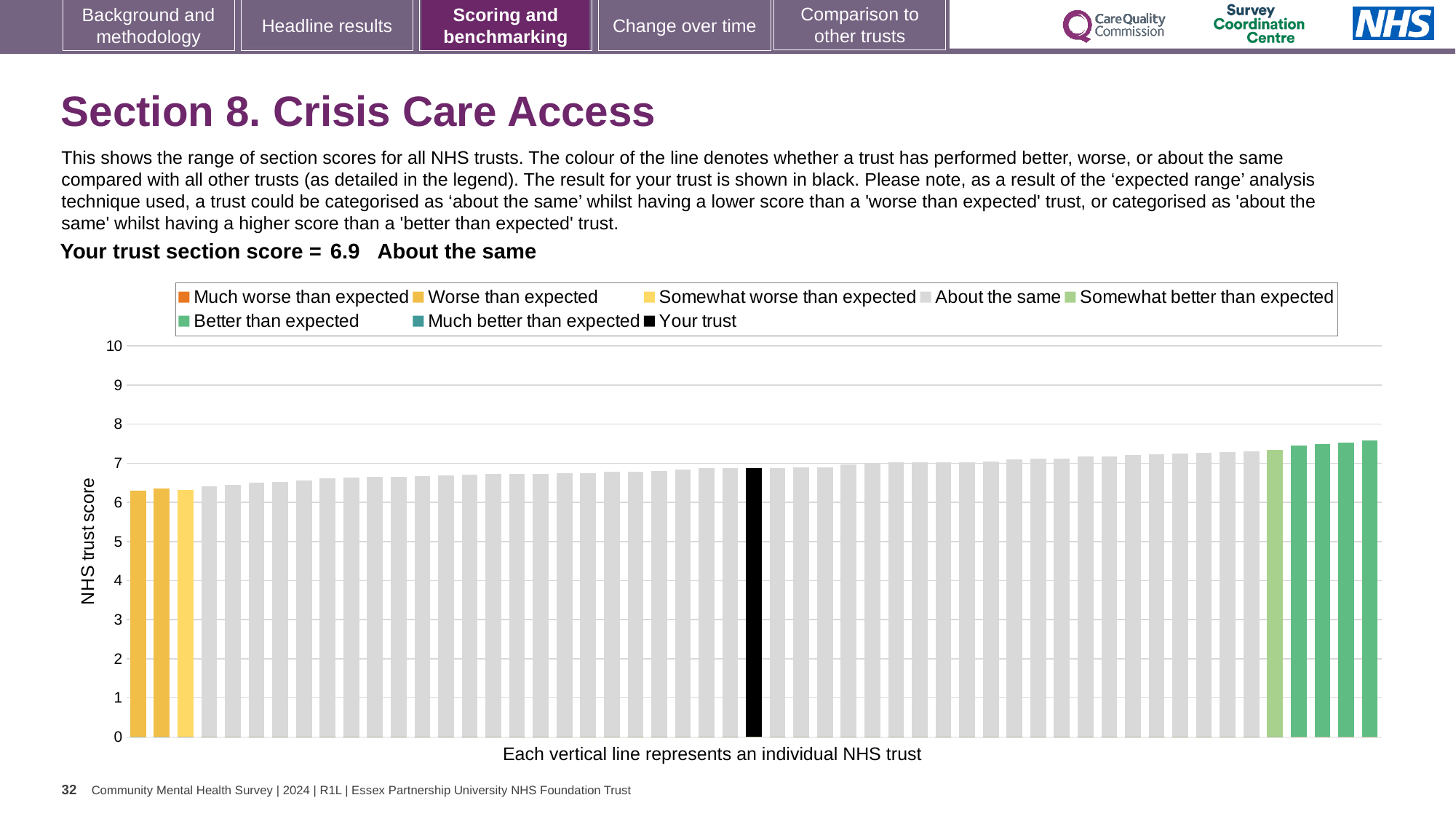
Is the value of the leftmost bar greater or less than 7? less Which bar is higher: the black bar for your trust or the leftmost yellow bar? The black bar for your trust What is the label on the vertical axis of the chart? NHS trust score Is the value of the black bar (your trust) greater or less than 6? greater What is the section score for your trust shown on the slide? 6.9 Which performance category is your trust placed in for Crisis Care Access? About the same Is the value of the rightmost bar greater or less than 7? greater Do the bar values rise or fall from left to right along the x axis? Rise How many bars are coloured as 'Better than expected' (green)? 4 How many entries does the chart legend list? 8 How many bars are coloured as 'Worse than expected' (yellow)? 2 What type of chart is shown on the slide? Bar chart